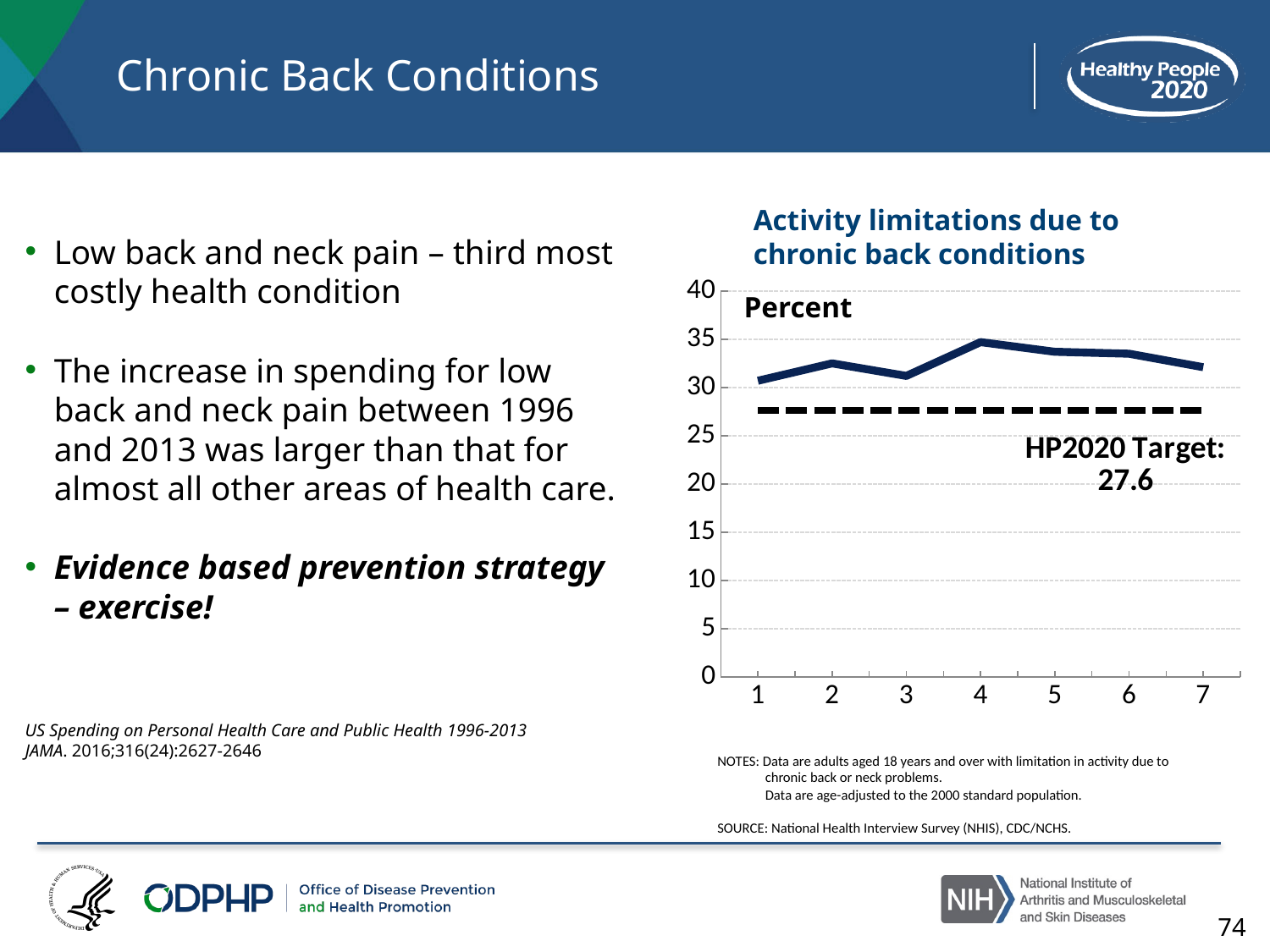
What unit label is printed on the y axis of the chart? Percent Is the value of the solid line at point 2 greater or less than 35? less What kind of chart is shown on the slide? line chart Is the value of the solid line at point 4 greater or less than 30? greater Which is larger, the solid line value at point 4 or at point 1? point 4 Is the solid line at point 5 above or below the HP2020 Target line? above What is the HP2020 Target value shown on the chart? 27.6 How many points are plotted along the x axis of the chart? 7 What is the title of the chart on the slide? Activity limitations due to chronic back conditions At which x-axis point does the solid line reach its highest value? 4 Is the value of the solid line at point 7 greater or less than 35? less Does the solid line rise or fall from point 4 to point 7? fall